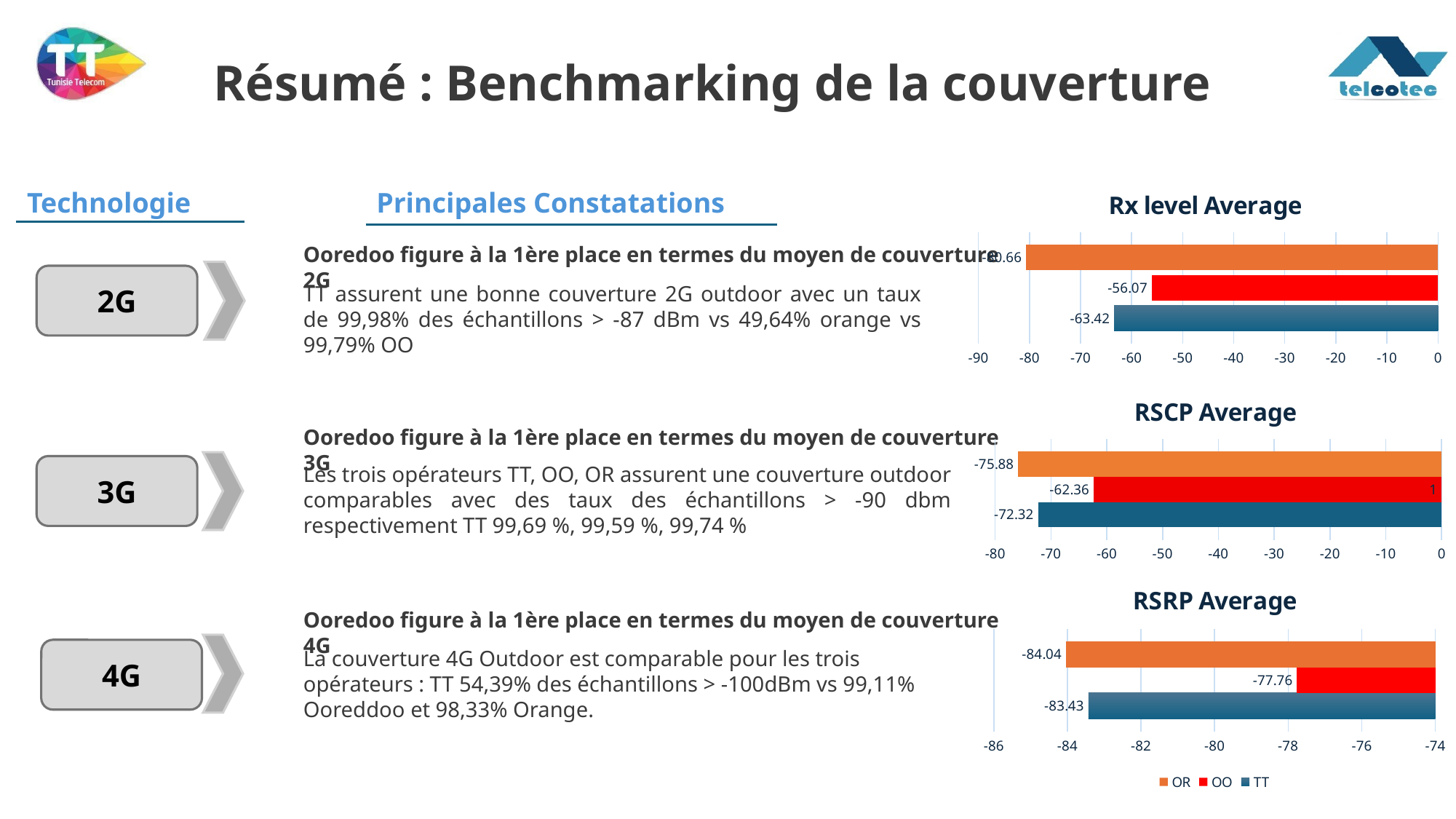
In the RSCP Average chart, what is the value for OO? -62.36 In the Rx level Average chart, what is the value for TT? -63.42 In the Rx level Average chart, is the value for OR greater or less than -70? less In the RSCP Average chart, what is the difference between the OO value and the TT value? 9.96 In the RSCP Average chart, which operator has the highest (least negative) value? OO In the RSCP Average chart, what is the value for OR? -75.88 In the Rx level Average chart, what is the value for OO? -56.07 In the RSRP Average chart, what is the value for OR? -84.04 In the RSRP Average chart, which is larger, the value for OR or the value for TT? TT How many series does the legend at the bottom of the slide list? 3 In the RSRP Average chart, what is the value for TT? -83.43 In the RSRP Average chart, what is the difference between the OO value and the TT value? 5.67